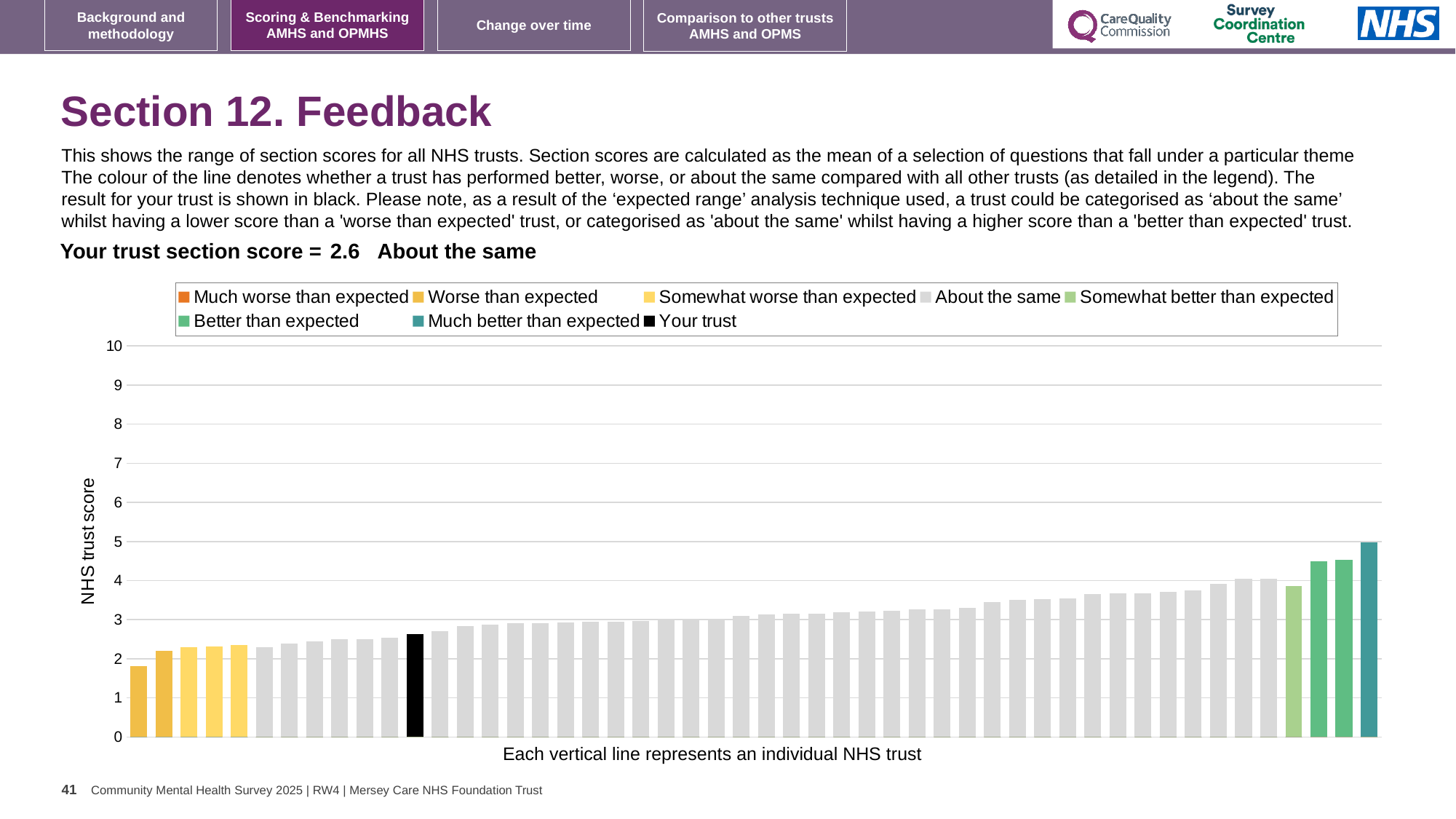
Is the value for your trust (the black bar) greater or less than 3? less What colour is used for the 'Your trust' bar in the chart? black Is the value of the shortest bar greater or less than 3? less What is the section score for your trust shown on the slide? 2.6 Is the value of the tallest bar greater or less than 4? greater What kind of chart is shown on the slide? bar chart How many entries does the chart legend list? 8 Do the bar values rise or fall from left to right along the x axis? rise How is your trust categorised compared with other trusts? About the same How many bars are coloured as 'Much better than expected'? 1 What is the label on the vertical axis of the chart? NHS trust score How many bars are coloured as 'Better than expected'? 2